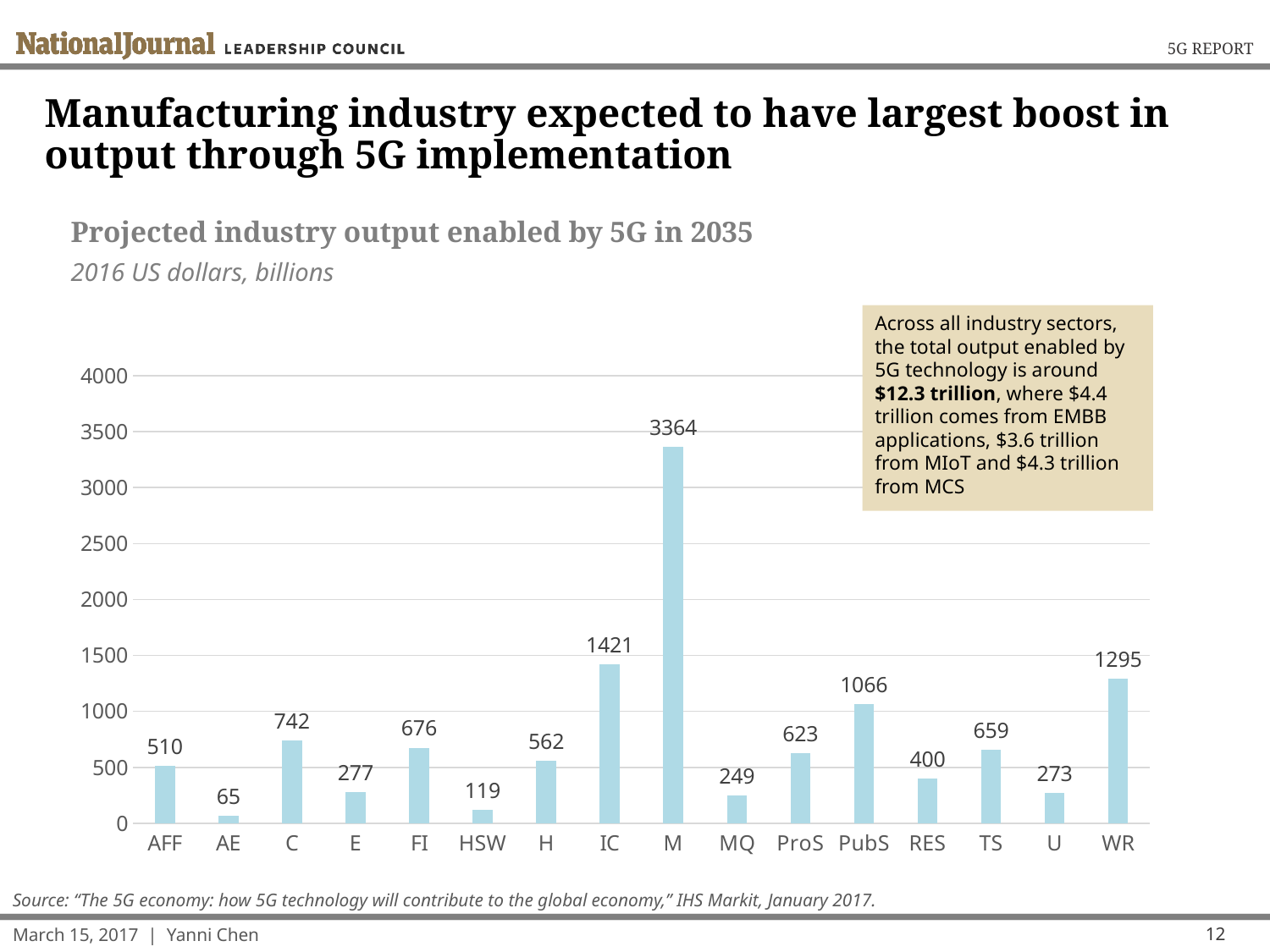
Which is larger, the value for C or the value for FI? C Which category has the lowest value? AE What is the difference between the values for PubS and RES? 666 What is the projected industry output enabled by 5G in 2035 for M? 3364 What is the value shown for IC? 1421 What is the difference between the values for M and IC? 1943 Which category has the highest value? M Is the value for WR greater or less than 1000? greater How many categories are shown on the x axis? 16 What unit is the chart's data expressed in, according to the subtitle? 2016 US dollars, billions What is the value shown for HSW? 119 What kind of chart is shown on the slide? Bar chart